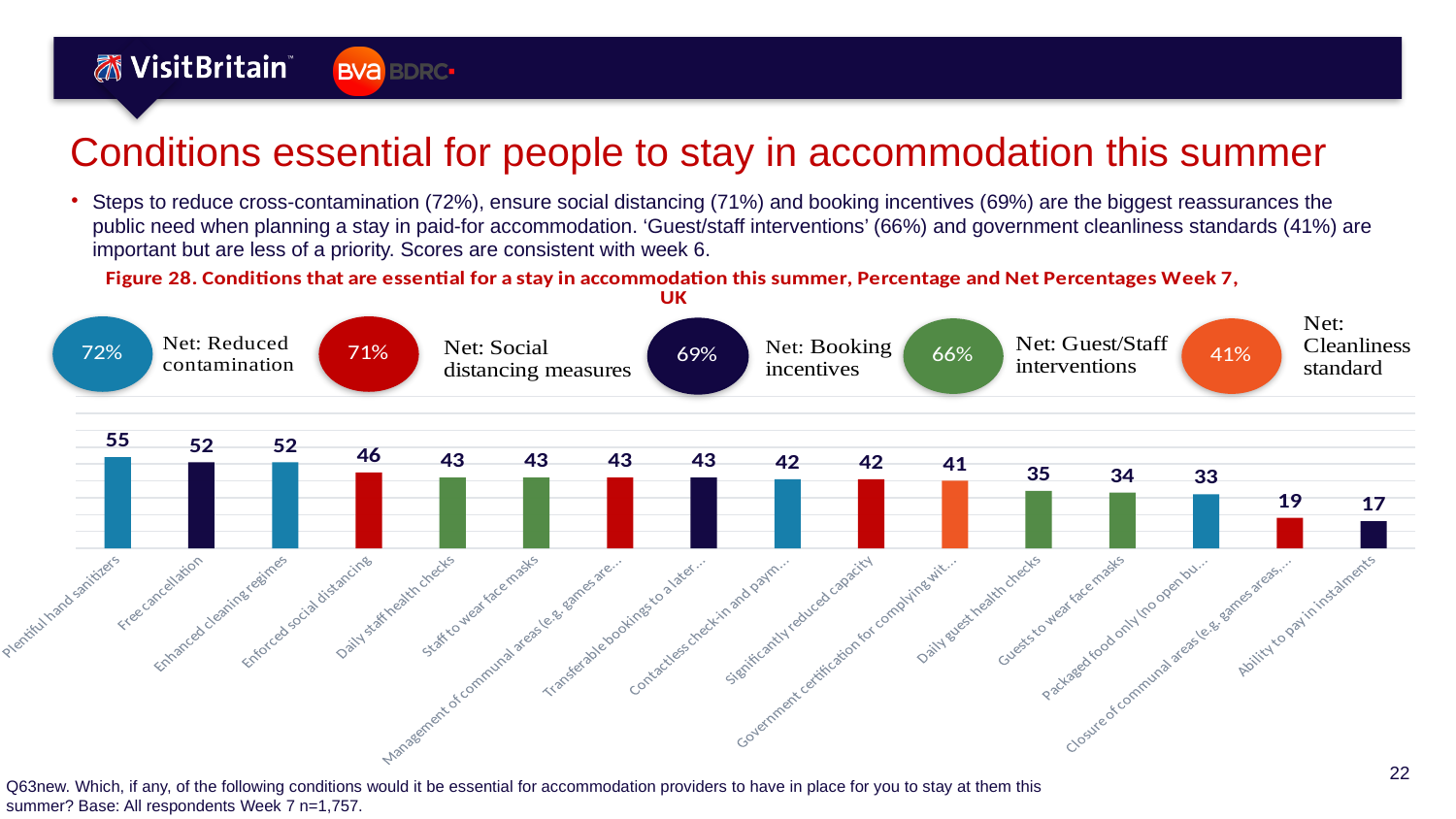
What is the difference between the values for Plentiful hand sanitizers and Free cancellation? 3 Which is larger, the value for Guests to wear face masks or the value for Daily guest health checks? Daily guest health checks How many bars are shown in the bar chart? 16 Do the values rise or fall from left to right along the x axis? Fall What is the net percentage shown for Cleanliness standard? 41% What is the value for Plentiful hand sanitizers? 55 Which category has the highest value in the bar chart? Plentiful hand sanitizers Which category has the lowest value in the bar chart? Ability to pay in instalments What is the value for Daily guest health checks? 35 What is the value for Ability to pay in instalments? 17 What kind of chart is used to show the conditions? Bar chart What is the value for Enforced social distancing? 46